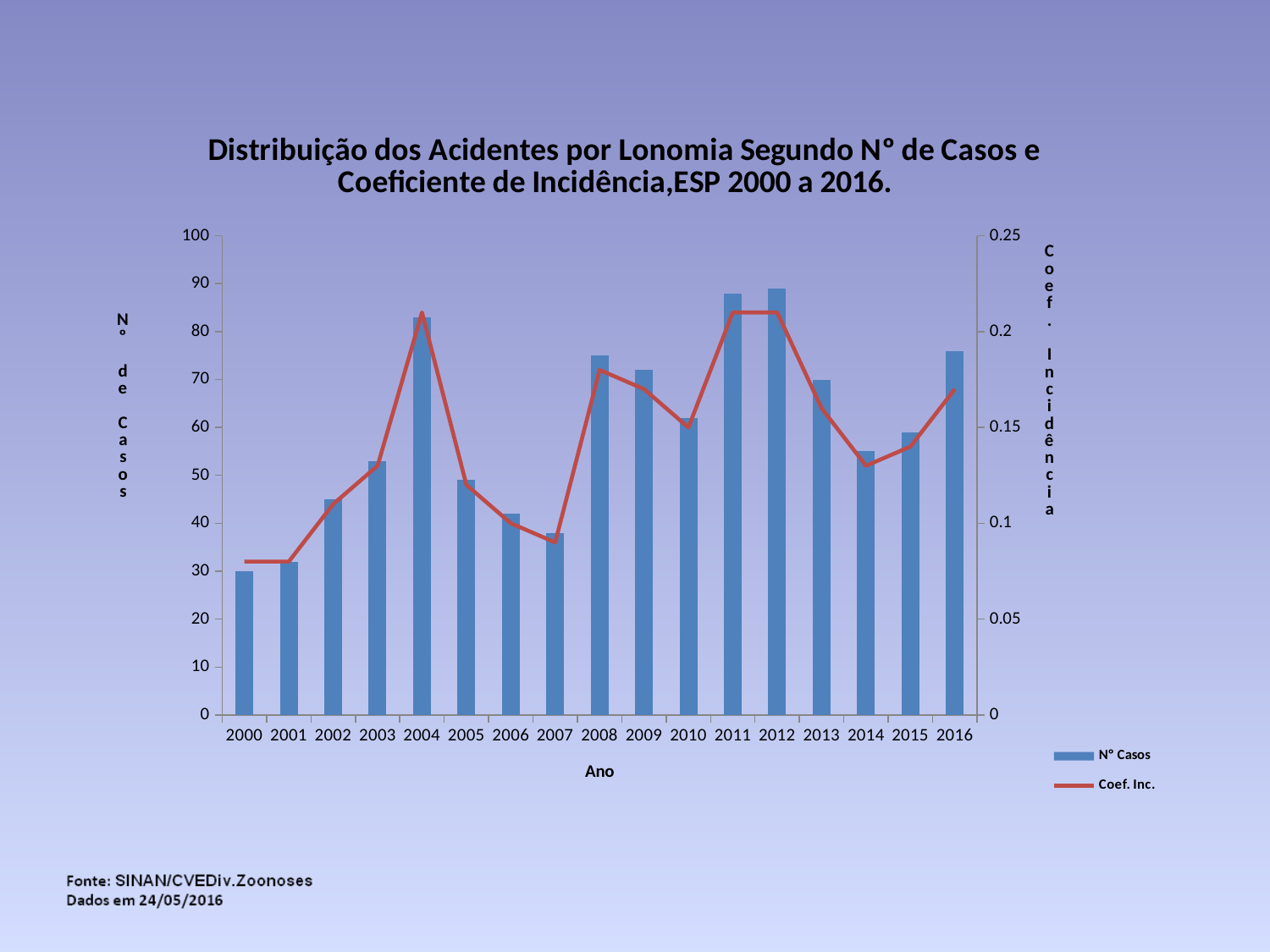
Is the number of cases (N° Casos) for 2007 greater or less than 40? less Is the number of cases (N° Casos) for 2014 greater or less than 60? less How many years are shown on the x axis? 17 Is the number of cases (N° Casos) for 2012 greater or less than 80? greater How many series does the legend list? 2 Which year has the larger number of cases, 2004 or 2008? 2004 What kind of chart is shown on the slide? A combined bar and line chart What colour is the Coef. Inc. line in the chart? Red Do the number of cases rise or fall from 2000 to 2004? rise